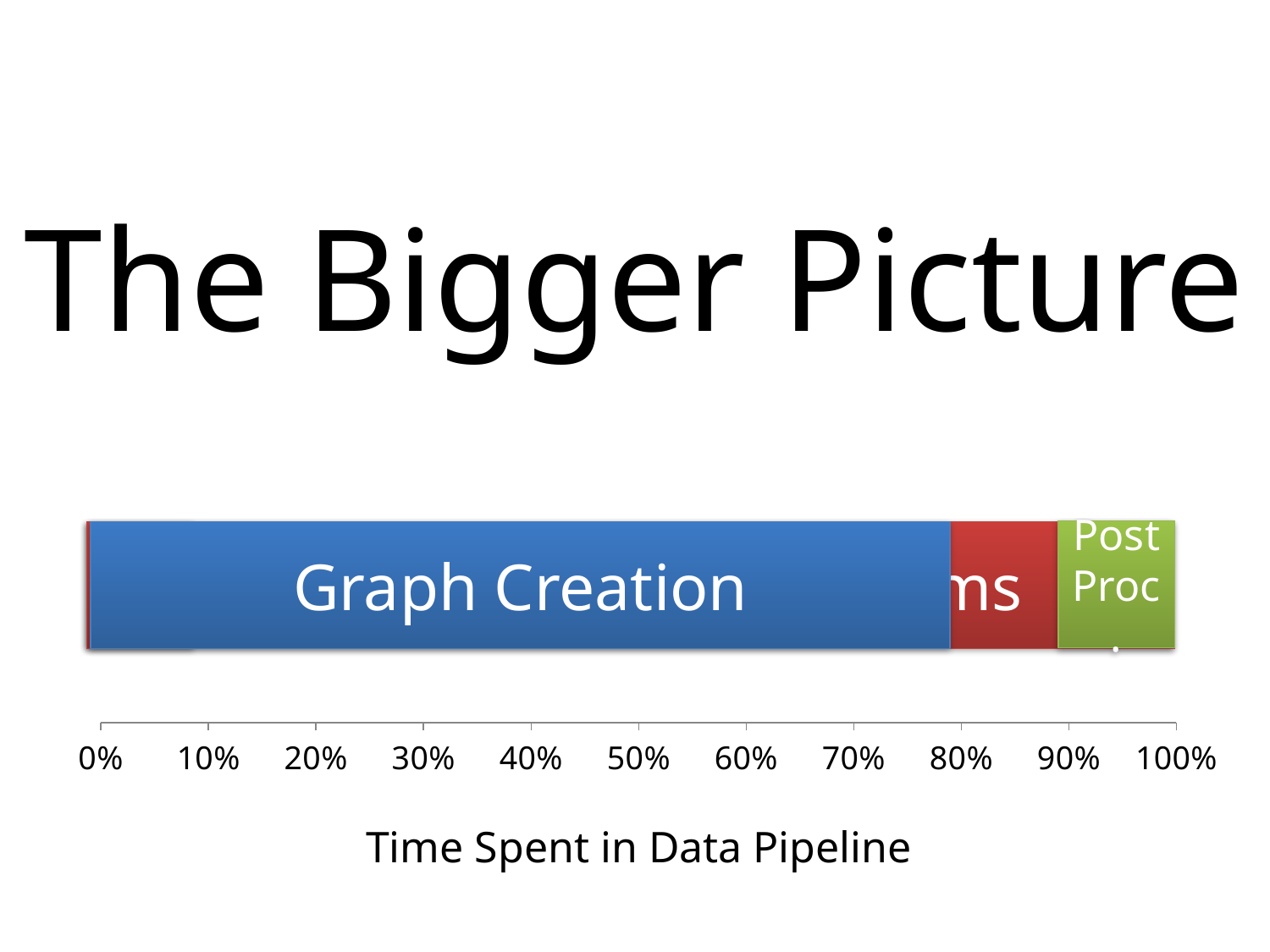
How many segments make up the stacked bar? 3 Is the share for Post Proc greater or less than 20%? less What is the title of the chart? Time Spent in Data Pipeline What kind of chart is shown on the slide? bar chart Which is larger, the Graph Creation segment or the Post Proc segment? Graph Creation What colour is the Graph Creation segment? blue What is the highest value shown on the x axis? 100% Which segment of the bar is the largest? Graph Creation Is the share for Graph Creation greater or less than 50%? greater Is the share for Graph Creation greater or less than 70%? greater